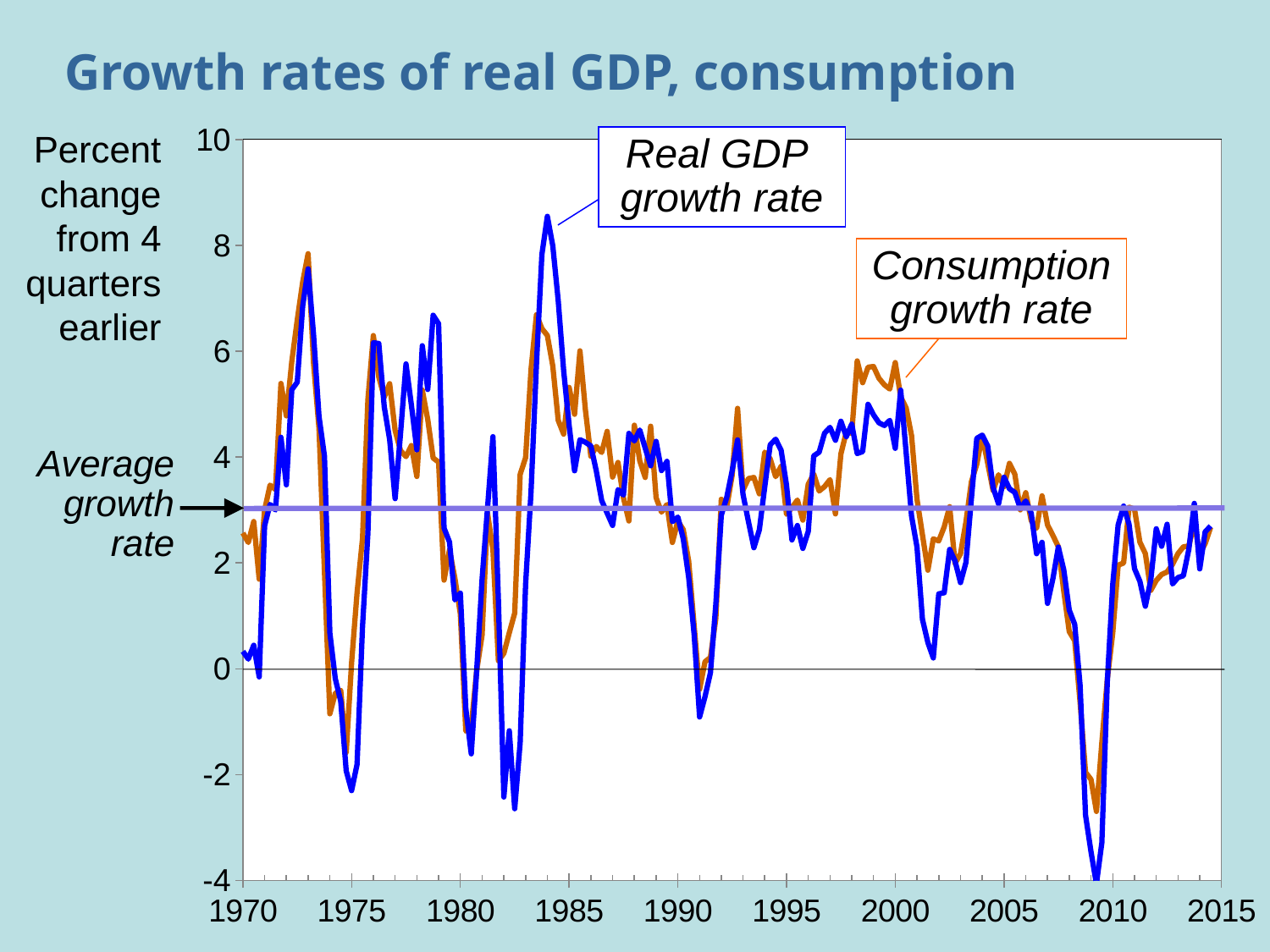
Which series is drawn in blue? Real GDP growth rate At the 1984 peak, which series is higher, Real GDP growth rate or Consumption growth rate? Real GDP growth rate Does the Real GDP growth rate rise or fall between its 1984 peak and 1991? fall How many growth-rate series are labeled on the chart (excluding the average line)? 2 What is the title of the chart? Growth rates of real GDP, consumption What kind of chart is shown on the slide? line chart Is the peak of the Real GDP growth rate around 1984 greater or less than 8? greater What is the highest value shown on the vertical axis? 10 Is the lowest value of the Real GDP growth rate around 2009 greater or less than -2? less At the 2009 trough, which series reaches the lower value, Real GDP growth rate or Consumption growth rate? Real GDP growth rate Is the peak of the Consumption growth rate around 1973 greater or less than 6? greater